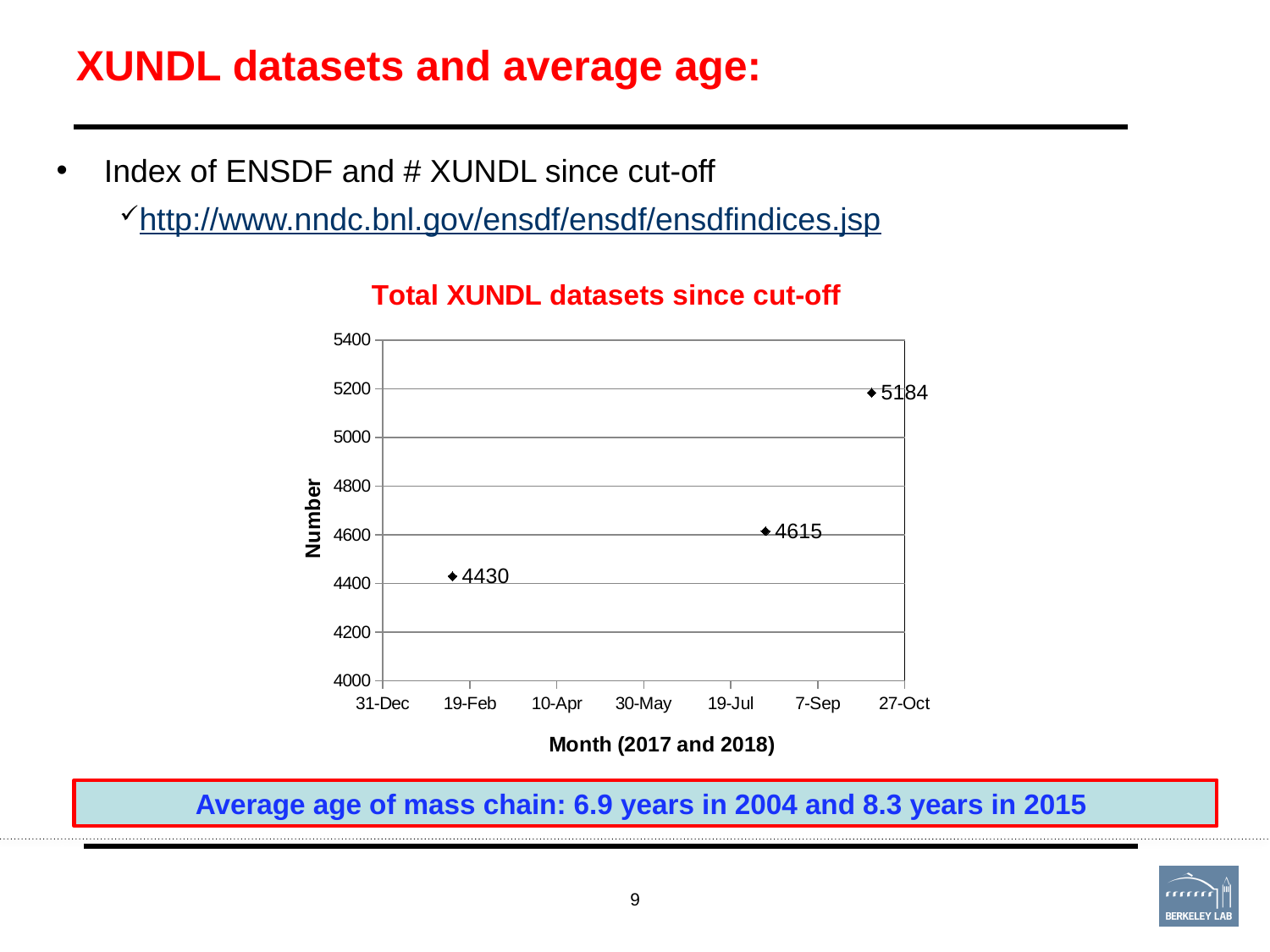
What is the lowest value plotted in the chart? 4430 What is the label on the x axis of the chart? Month (2017 and 2018) How many data points are plotted in the chart? 3 What is the value of the rightmost data point in the chart? 5184 Do the plotted values rise or fall from left to right along the x axis? rise What is the value of the leftmost data point in the chart? 4430 What type of chart is shown under the title 'Total XUNDL datasets since cut-off'? scatter chart What is the difference between the highest and lowest plotted values? 754 What is the value of the middle data point in the chart? 4615 What is the highest value plotted in the chart? 5184 What is the difference between the rightmost point (5184) and the middle point (4615)? 569 What is the label on the y axis of the chart? Number